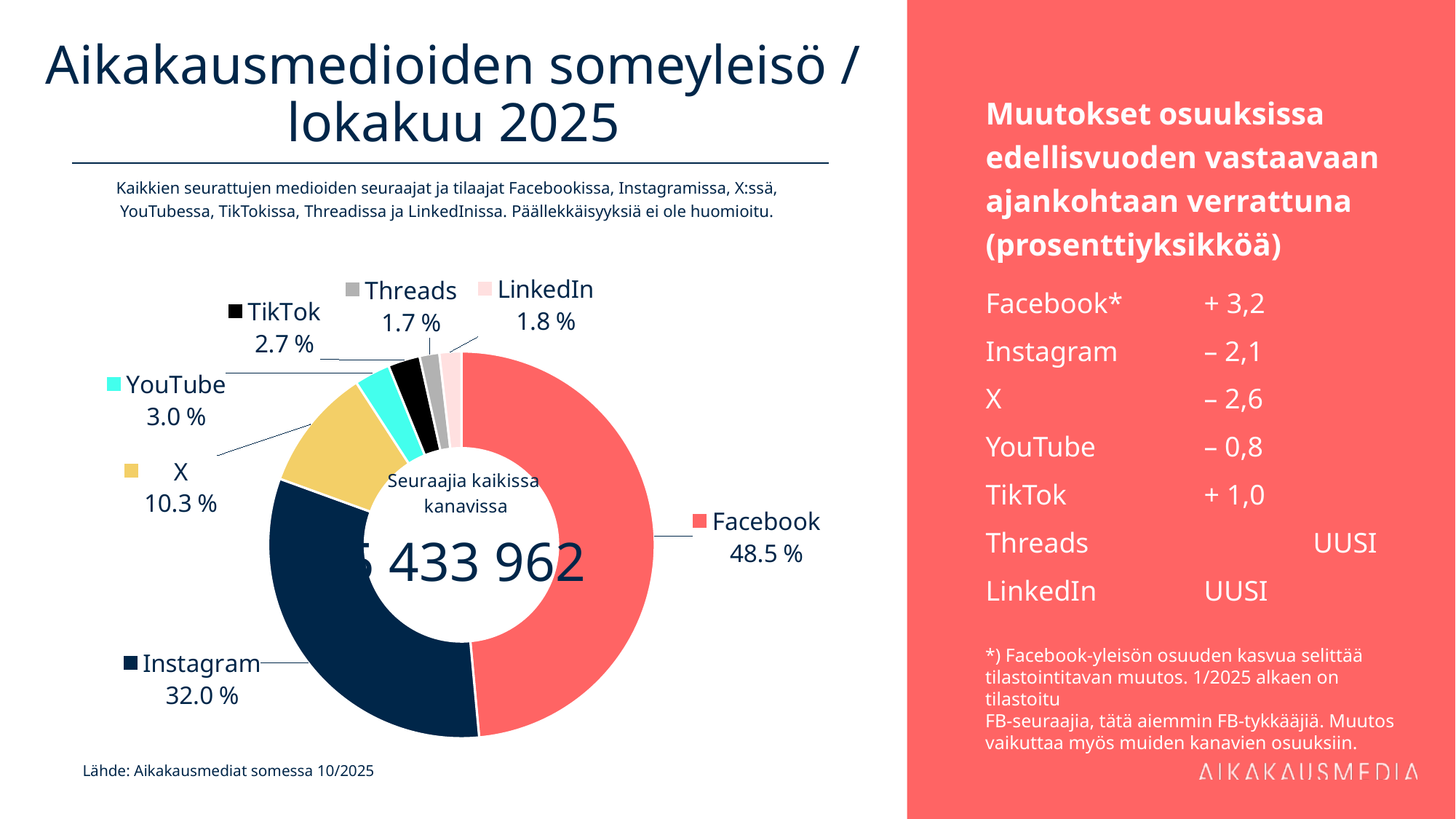
What percentage is shown for X in the chart? 10.3 % What type of chart is shown on the slide? Doughnut chart What colour is the Facebook segment in the chart? Red What is the difference in percentage points between Facebook's and Instagram's shares? 16.5 How many channels are shown as segments in the chart? 7 Which has a larger share, Threads or LinkedIn? LinkedIn What is the value shown for Instagram in the chart? 32.0 % Which has a larger share, TikTok or YouTube? YouTube What share of the doughnut chart does Facebook account for? 48.5 % What is the value shown for YouTube? 3.0 % Which channel has the largest share in the chart? Facebook Which channel has the smallest share in the chart? Threads